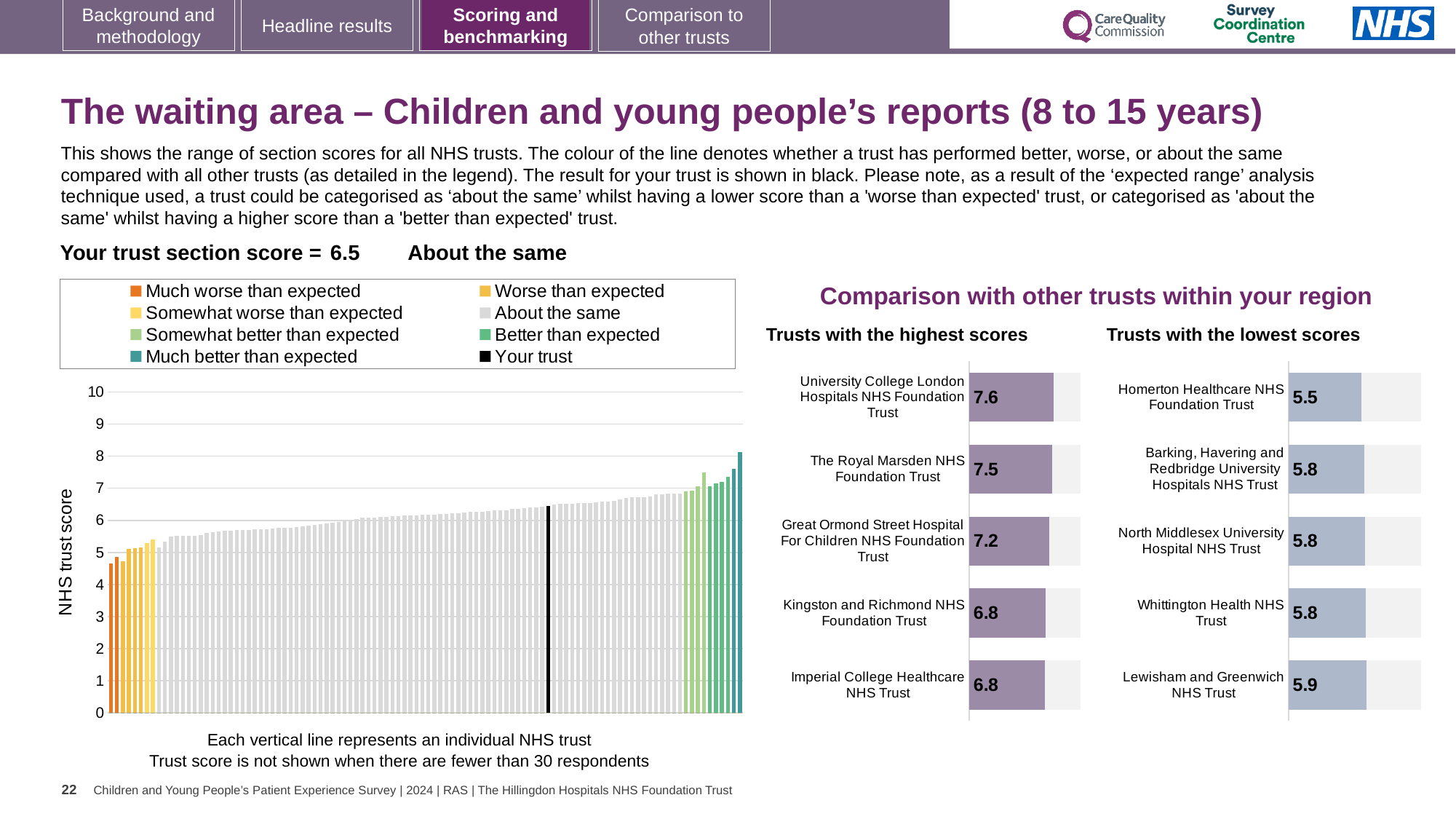
In the main 'NHS trust score' chart on the left, do the trust scores rise or fall from left to right? Rise In the 'Trusts with the highest scores' chart, what is the score for Great Ormond Street Hospital For Children NHS Foundation Trust? 7.2 In the 'Trusts with the lowest scores' chart, what is the score for Homerton Healthcare NHS Foundation Trust? 5.5 In the 'Trusts with the lowest scores' chart, what is the score for Lewisham and Greenwich NHS Trust? 5.9 In the 'Trusts with the lowest scores' chart, which trust has the lowest score? Homerton Healthcare NHS Foundation Trust In the 'Trusts with the highest scores' chart, what is the difference between the scores of University College London Hospitals NHS Foundation Trust and Great Ormond Street Hospital For Children NHS Foundation Trust? 0.4 How many trusts are shown in the 'Trusts with the highest scores' chart? 5 In the 'Trusts with the lowest scores' chart, which has the larger score: Homerton Healthcare NHS Foundation Trust or Lewisham and Greenwich NHS Trust? Lewisham and Greenwich NHS Trust What kind of chart is the main 'NHS trust score' chart on the left? Bar chart In the 'Trusts with the highest scores' chart, which trust has the highest score? University College London Hospitals NHS Foundation Trust In the main 'NHS trust score' chart on the left, how many entries does the legend list? 8 In the 'Trusts with the highest scores' chart, what is the score for University College London Hospitals NHS Foundation Trust? 7.6